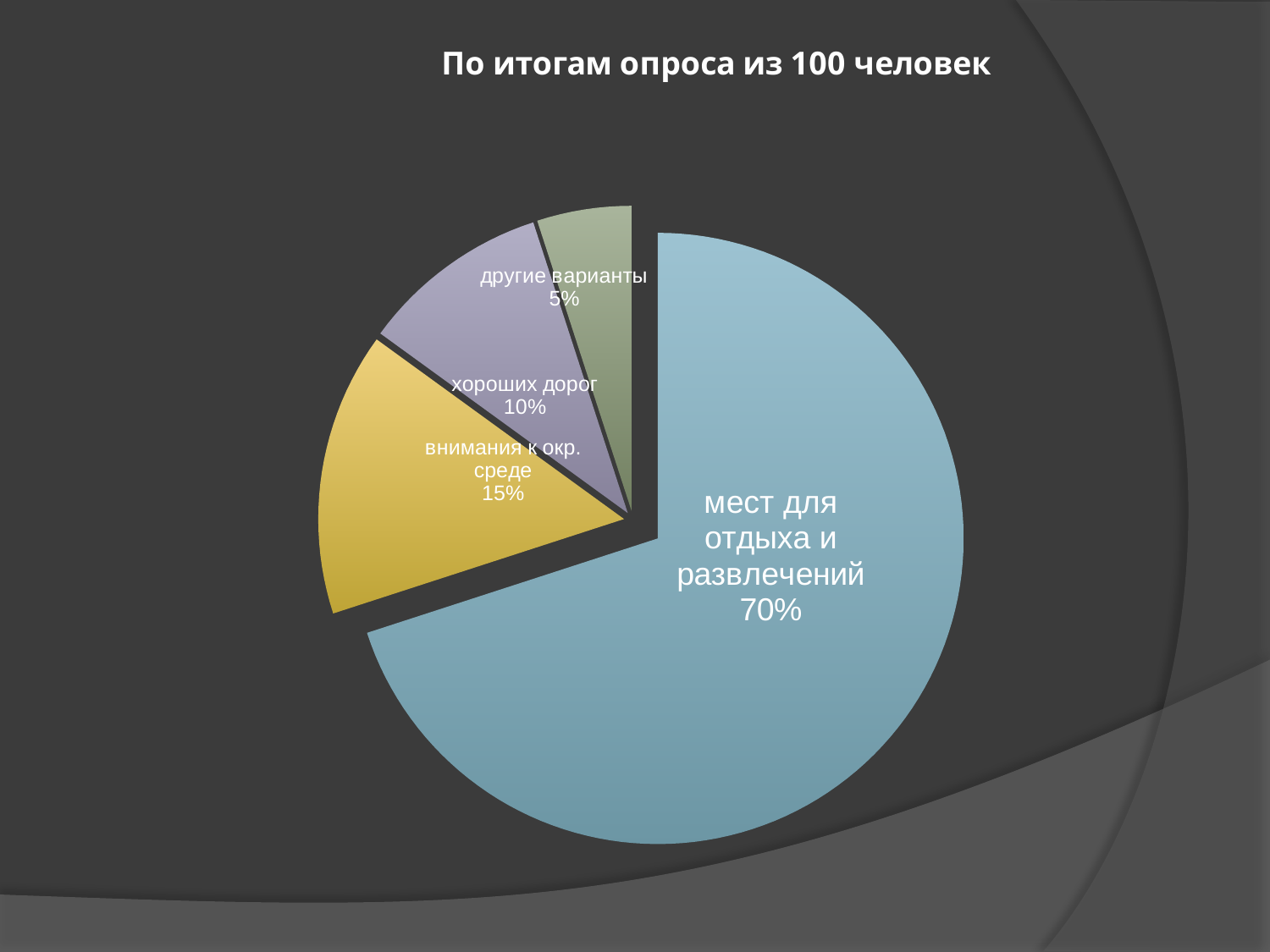
What is the difference between the values for "внимания к окр. среде" and "хороших дорог"? 5% What is the value shown for "внимания к окр. среде"? 15% Which is larger, the value for "хороших дорог" or the value for "другие варианты"? хороших дорог What is the title of the chart on the slide? По итогам опроса из 100 человек What is the value shown for "хороших дорог"? 10% What kind of chart is shown on the slide? pie chart What share of the pie does "мест для отдыха и развлечений" take? 70% What is the difference between the values for "мест для отдыха и развлечений" and "внимания к окр. среде"? 55% What is the value shown for "другие варианты"? 5% Which category has the smallest slice of the pie? другие варианты How many slices does the pie chart have? 4 Which category has the largest slice of the pie? мест для отдыха и развлечений